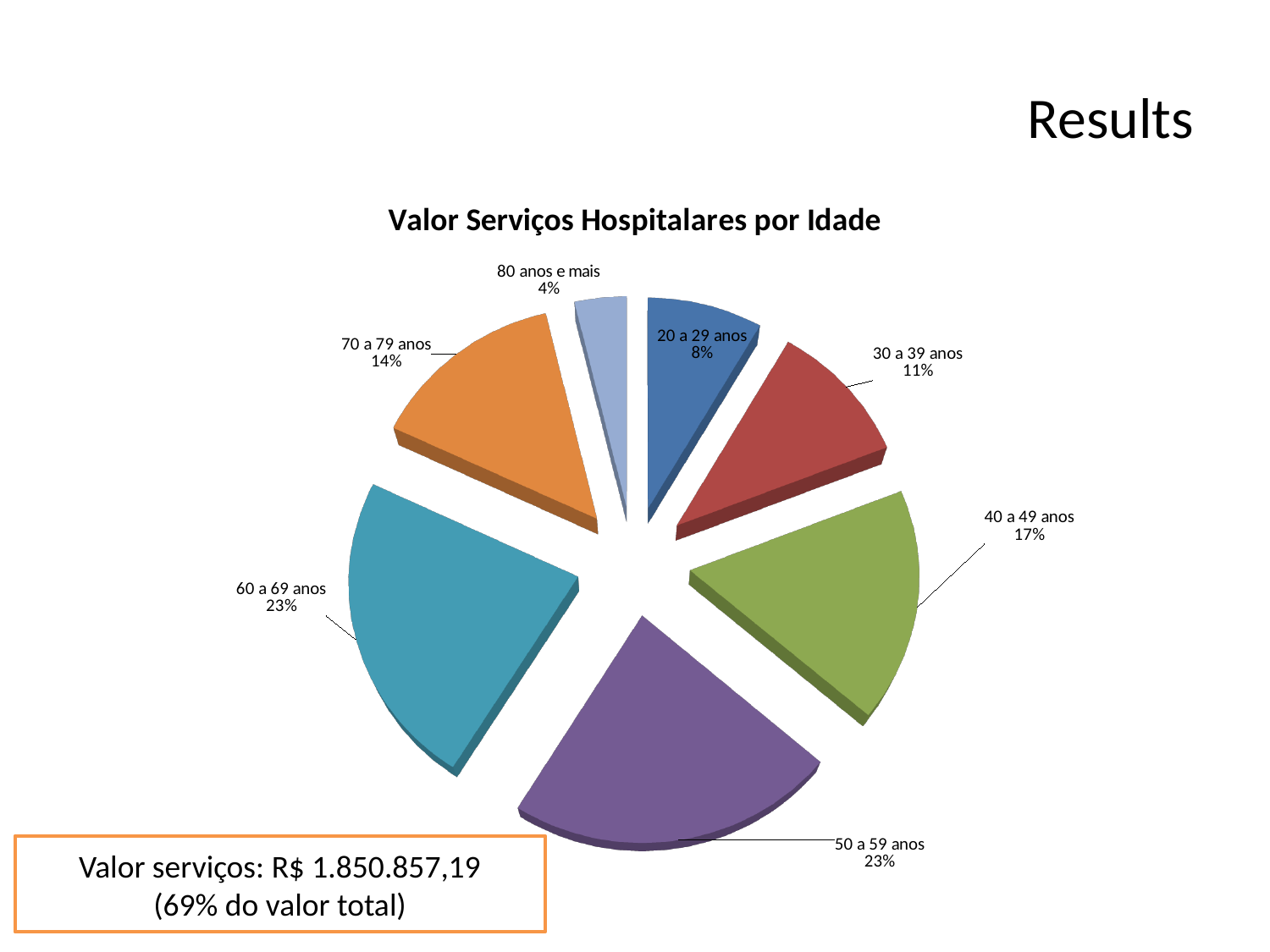
What share of the pie does the "30 a 39 anos" slice represent? 11% What share of the pie does the "40 a 49 anos" slice represent? 17% Which age group has the smallest slice of the pie? 80 anos e mais What share of the pie does the "70 a 79 anos" slice represent? 14% What is the title of the chart? Valor Serviços Hospitalares por Idade How many slices does the pie chart have? 7 Which two age groups share the same percentage of 23%? 50 a 59 anos and 60 a 69 anos What is the difference in percentage points between the "50 a 59 anos" slice and the "30 a 39 anos" slice? 12 percentage points What is the difference in percentage points between the "40 a 49 anos" slice and the "80 anos e mais" slice? 13 percentage points What kind of chart is shown on the slide? pie chart Which slice is larger, "60 a 69 anos" or "70 a 79 anos"? 60 a 69 anos